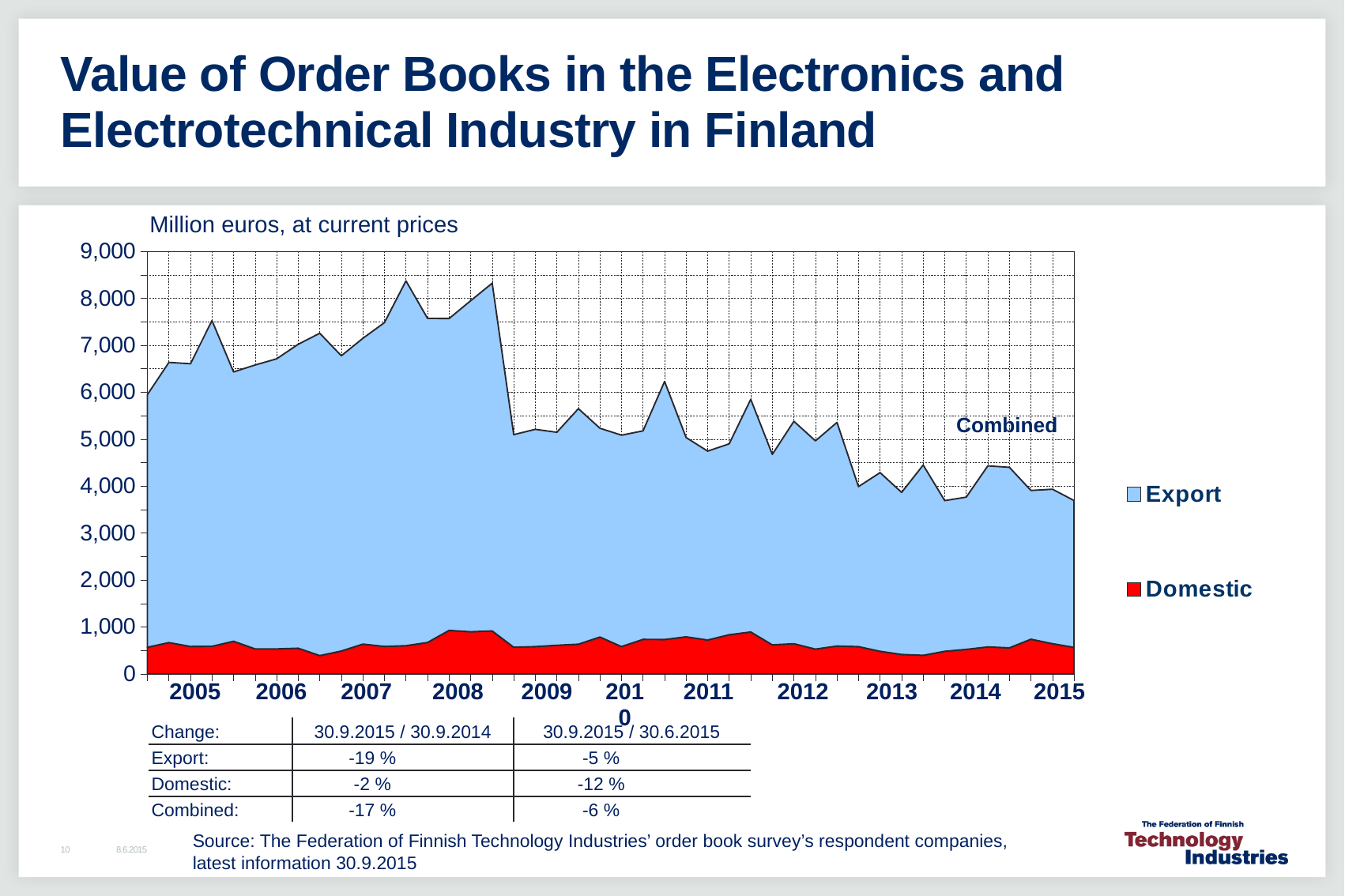
What kind of chart is shown on the slide? Area chart Which two series are listed in the chart legend? Export and Domestic What unit is stated above the chart for the plotted values? Million euros, at current prices Which series is larger throughout the chart, Export or Domestic? Export How many series does the chart legend list? 2 Is the combined value larger at the start of 2005 or at the end of 2015? 2005 How many years are labelled on the x axis of the chart? 11 Does the combined value of order books generally rise or fall from 2008 to 2015? fall Is the Domestic value at its 2008 peak greater or less than 1,000? less Is the peak combined value in 2008 greater or less than 8,000? greater Is the combined value at the end of 2015 greater or less than 4,000? less